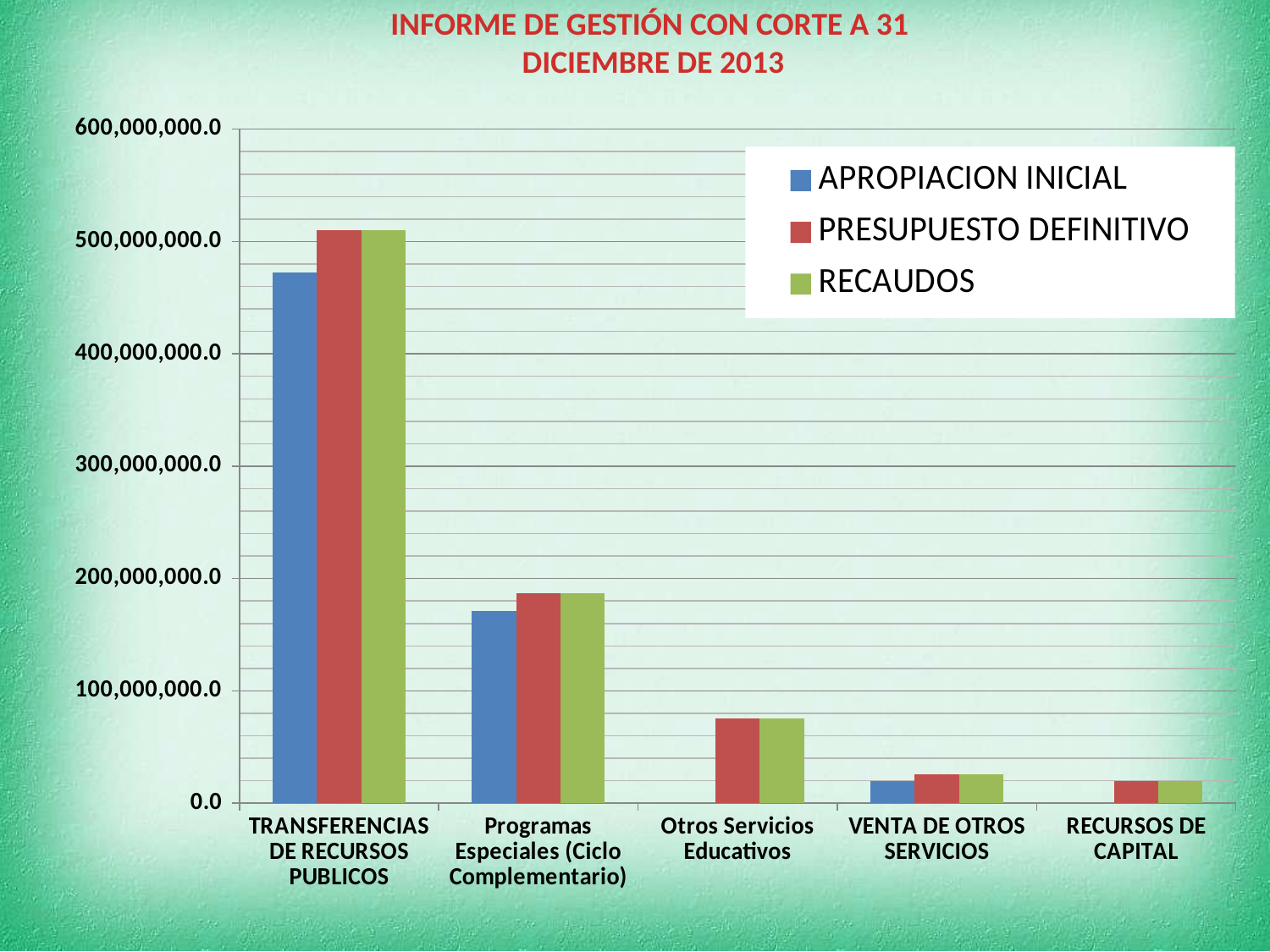
Is the RECAUDOS value for Otros Servicios Educativos greater or less than 100,000,000.0? less Is the PRESUPUESTO DEFINITIVO value for Programas Especiales (Ciclo Complementario) greater or less than 200,000,000.0? less Is the APROPIACION INICIAL value for TRANSFERENCIAS DE RECURSOS PUBLICOS greater or less than 400,000,000.0? greater Which category has the lowest RECAUDOS value? RECURSOS DE CAPITAL What is the title of the slide? INFORME DE GESTIÓN CON CORTE A 31 DICIEMBRE DE 2013 Do the PRESUPUESTO DEFINITIVO values rise or fall moving from left to right along the x axis? fall How many categories are shown along the x axis? 5 Which colour represents RECAUDOS in the legend? green What kind of chart is shown on the slide? bar chart For TRANSFERENCIAS DE RECURSOS PUBLICOS, which is larger: APROPIACION INICIAL or PRESUPUESTO DEFINITIVO? PRESUPUESTO DEFINITIVO How many series does the legend list? 3 Which category has the highest PRESUPUESTO DEFINITIVO value? TRANSFERENCIAS DE RECURSOS PUBLICOS